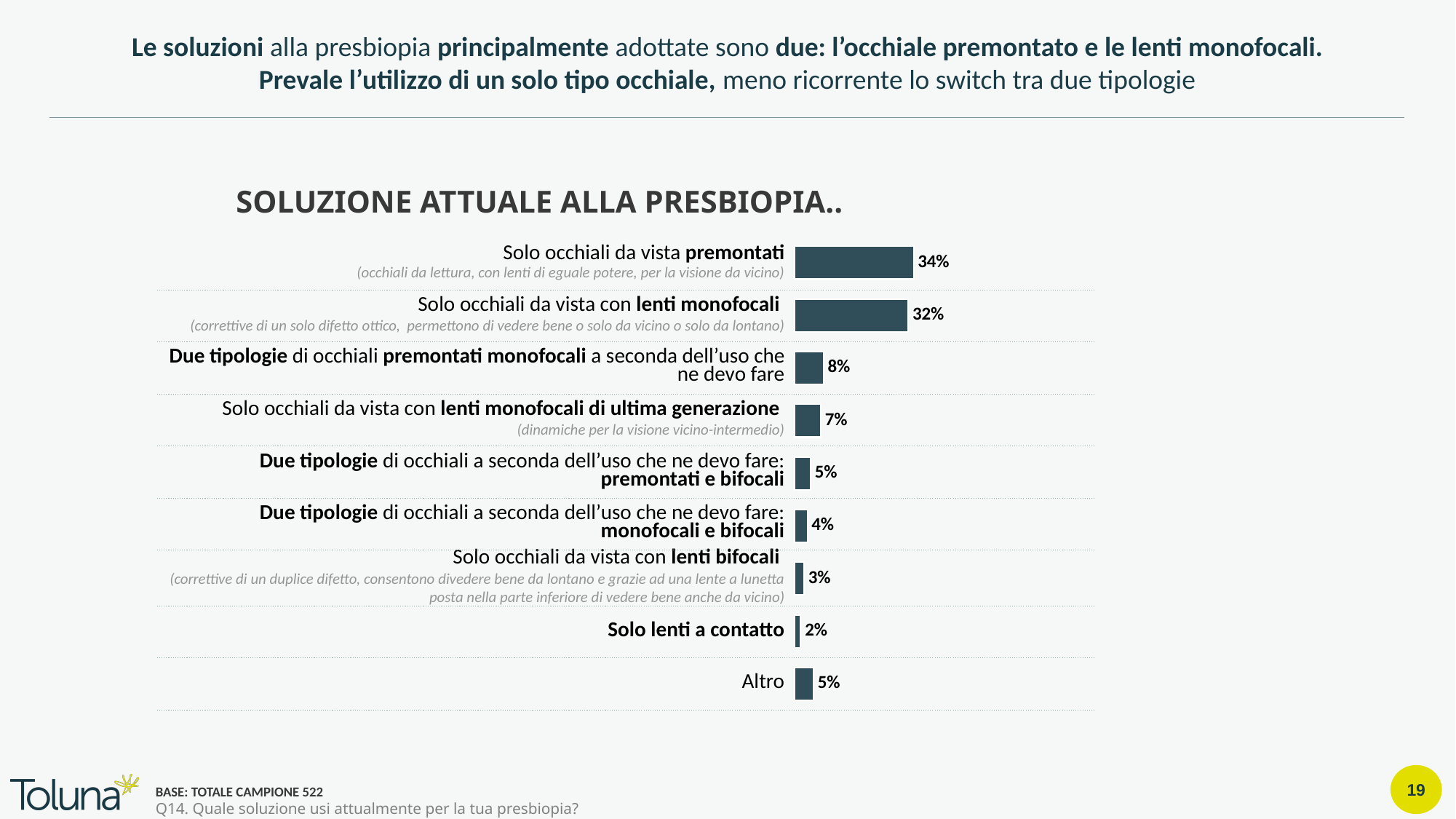
What is the difference between 'Solo occhiali da vista premontati' and 'Solo occhiali da vista con lenti monofocali'? 2% What is the value for 'Solo occhiali da vista premontati'? 34% Which category has the lowest value? Solo lenti a contatto What is the value for 'Altro'? 5% What is the value for 'Solo lenti a contatto'? 2% What is the value for 'Due tipologie di occhiali premontati monofocali a seconda dell'uso che ne devo fare'? 8% Which is larger: 'Solo occhiali da vista con lenti monofocali di ultima generazione' or 'Solo occhiali da vista con lenti bifocali'? Solo occhiali da vista con lenti monofocali di ultima generazione What is the title of the chart? SOLUZIONE ATTUALE ALLA PRESBIOPIA.. Which category has the highest value? Solo occhiali da vista premontati How many categories are shown in the chart? 9 What kind of chart is shown on the slide? Bar chart What is the value for 'Solo occhiali da vista con lenti monofocali'? 32%